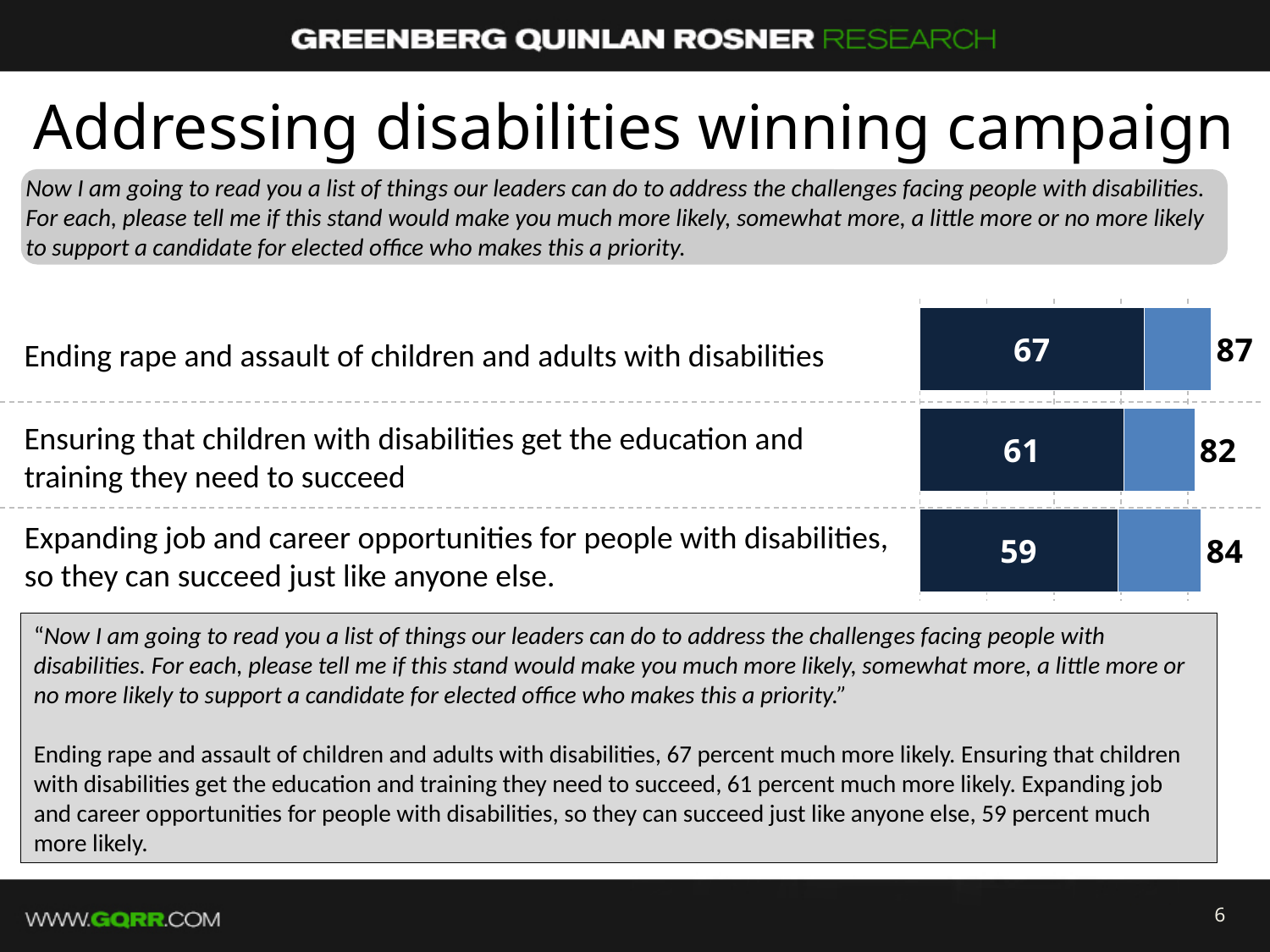
How many categories are shown in the chart? 3 What is the total value printed at the end of the bar for "Expanding job and career opportunities for people with disabilities, so they can succeed just like anyone else."? 84 What is the total value printed at the end of the bar for "Ensuring that children with disabilities get the education and training they need to succeed"? 82 Which category has the highest dark blue value? Ending rape and assault of children and adults with disabilities What is the dark blue value for "Ending rape and assault of children and adults with disabilities"? 67 What is the dark blue value for "Expanding job and career opportunities for people with disabilities, so they can succeed just like anyone else."? 59 What is the dark blue value for "Ensuring that children with disabilities get the education and training they need to succeed"? 61 What is the difference between the dark blue values for "Ending rape and assault of children and adults with disabilities" and "Expanding job and career opportunities for people with disabilities, so they can succeed just like anyone else."? 8 What is the total value printed at the end of the bar for "Ending rape and assault of children and adults with disabilities"? 87 Which category has the lowest dark blue value? Expanding job and career opportunities for people with disabilities, so they can succeed just like anyone else. Which category has the lowest total value? Ensuring that children with disabilities get the education and training they need to succeed Which is larger: the total for "Ensuring that children with disabilities get the education and training they need to succeed" or the total for "Expanding job and career opportunities for people with disabilities, so they can succeed just like anyone else."? Expanding job and career opportunities for people with disabilities, so they can succeed just like anyone else.